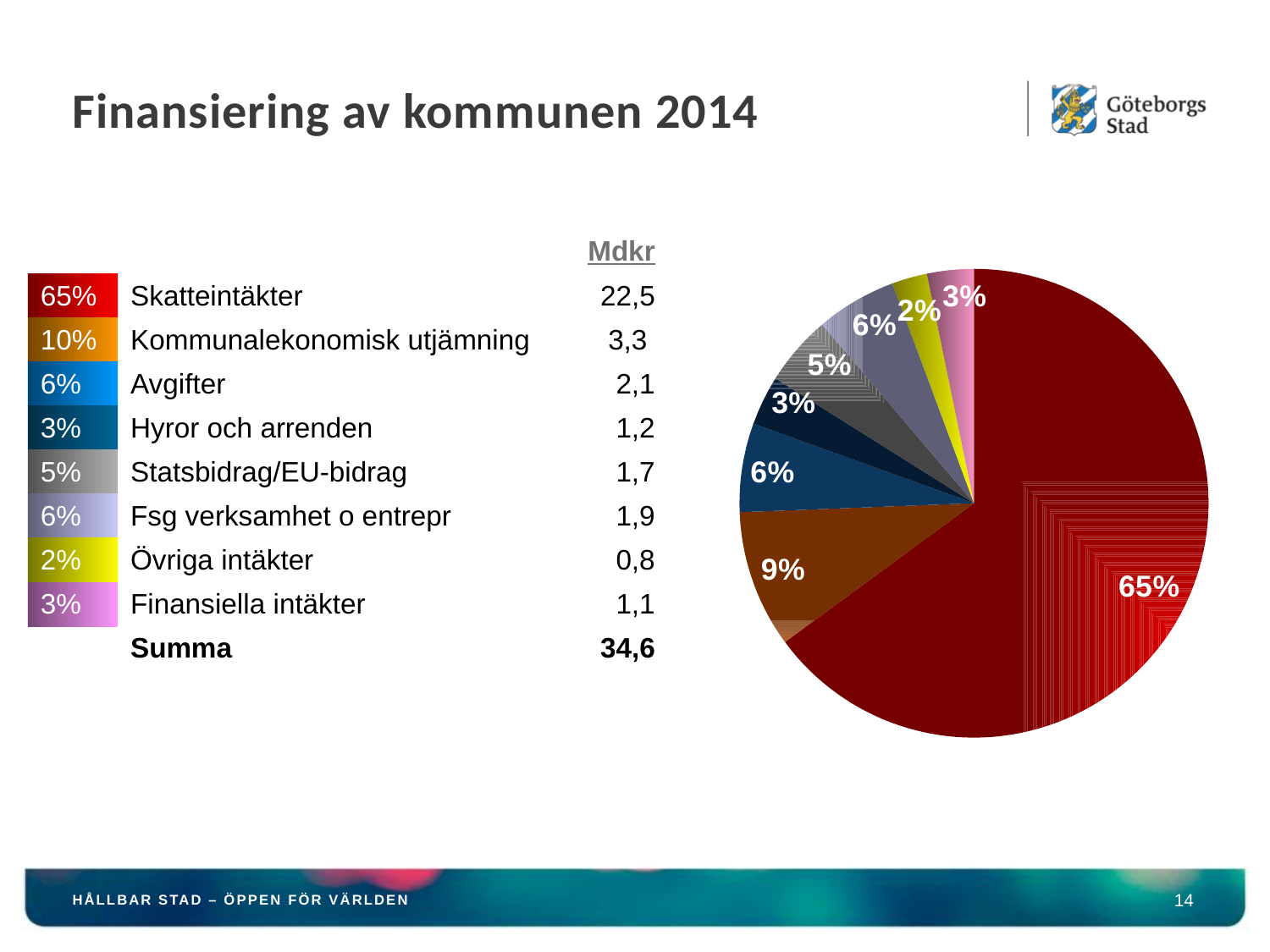
Which is larger in Mdkr, Avgifter or Hyror och arrenden? Avgifter What share of the pie does Skatteintäkter represent? 65% Which category has the smallest slice of the pie? Övriga intäkter What is the difference in Mdkr between Skatteintäkter and Kommunalekonomisk utjämning? 19,2 What is the Mdkr value for Statsbidrag/EU-bidrag? 1,7 What kind of chart is shown on the slide? pie chart What percentage label is printed on the pie slice for Kommunalekonomisk utjämning? 9% What is the total (Summa) in Mdkr of all categories? 34,6 Which category has the largest slice of the pie? Skatteintäkter How many slices does the pie chart have? 8 What is the Mdkr value for Avgifter? 2,1 What colour is the Skatteintäkter slice in the pie chart? dark red